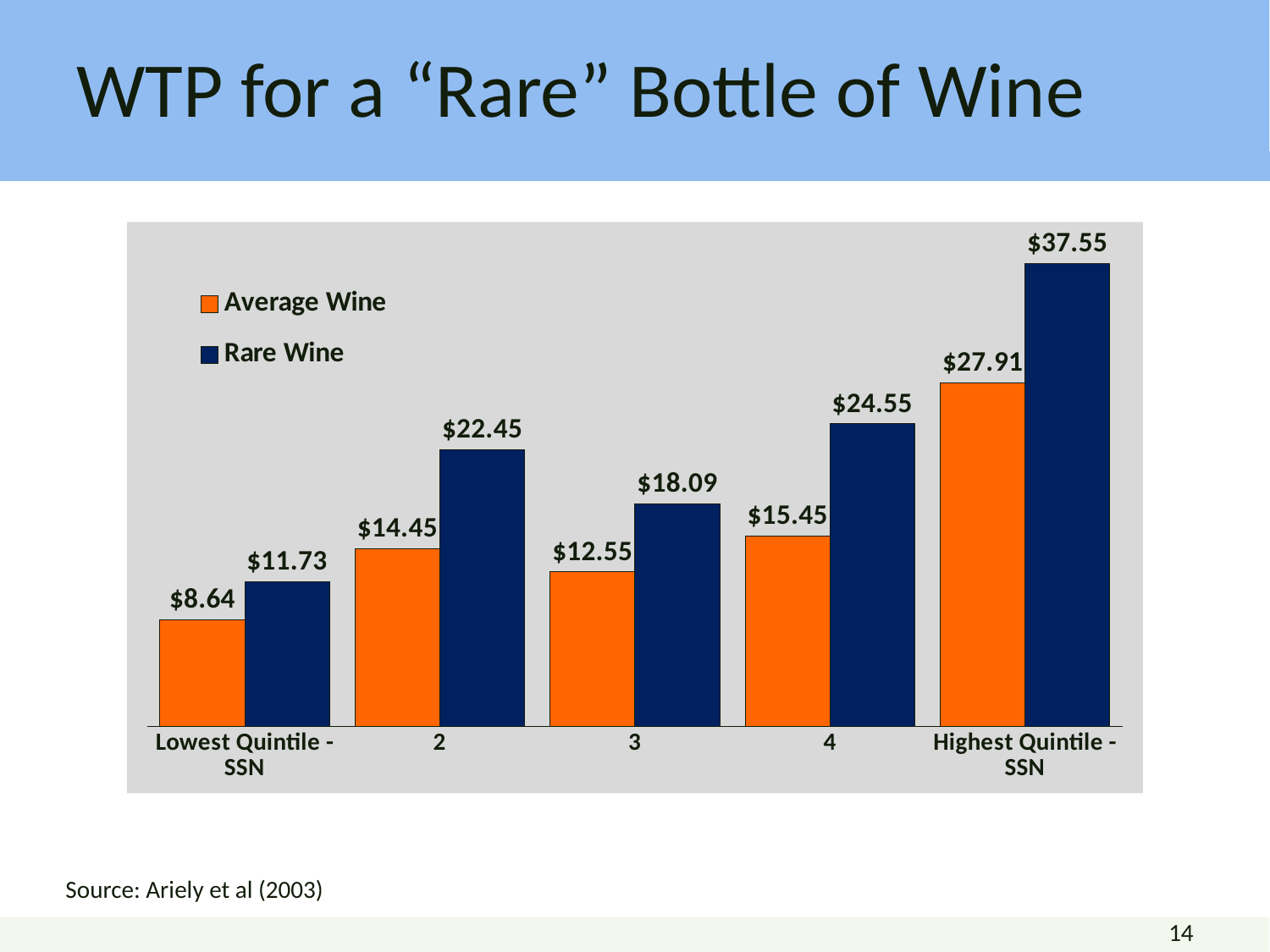
Which is larger for category 2: the Average Wine value or the Rare Wine value? Rare Wine What is the difference between the Rare Wine and Average Wine values for the Highest Quintile - SSN? $9.64 What kind of chart is shown on the slide? Bar chart Which category has the lowest Average Wine value? Lowest Quintile - SSN What is the Average Wine value for category 4? $15.45 Which category has the highest Rare Wine value? Highest Quintile - SSN How many series does the legend list? 2 What is the Rare Wine value for the Highest Quintile - SSN? $37.55 How many categories are shown on the x axis? 5 What is the difference between the Rare Wine values for category 2 and category 3? $4.36 What is the Average Wine value for the Lowest Quintile - SSN? $8.64 What is the Rare Wine value for category 3? $18.09